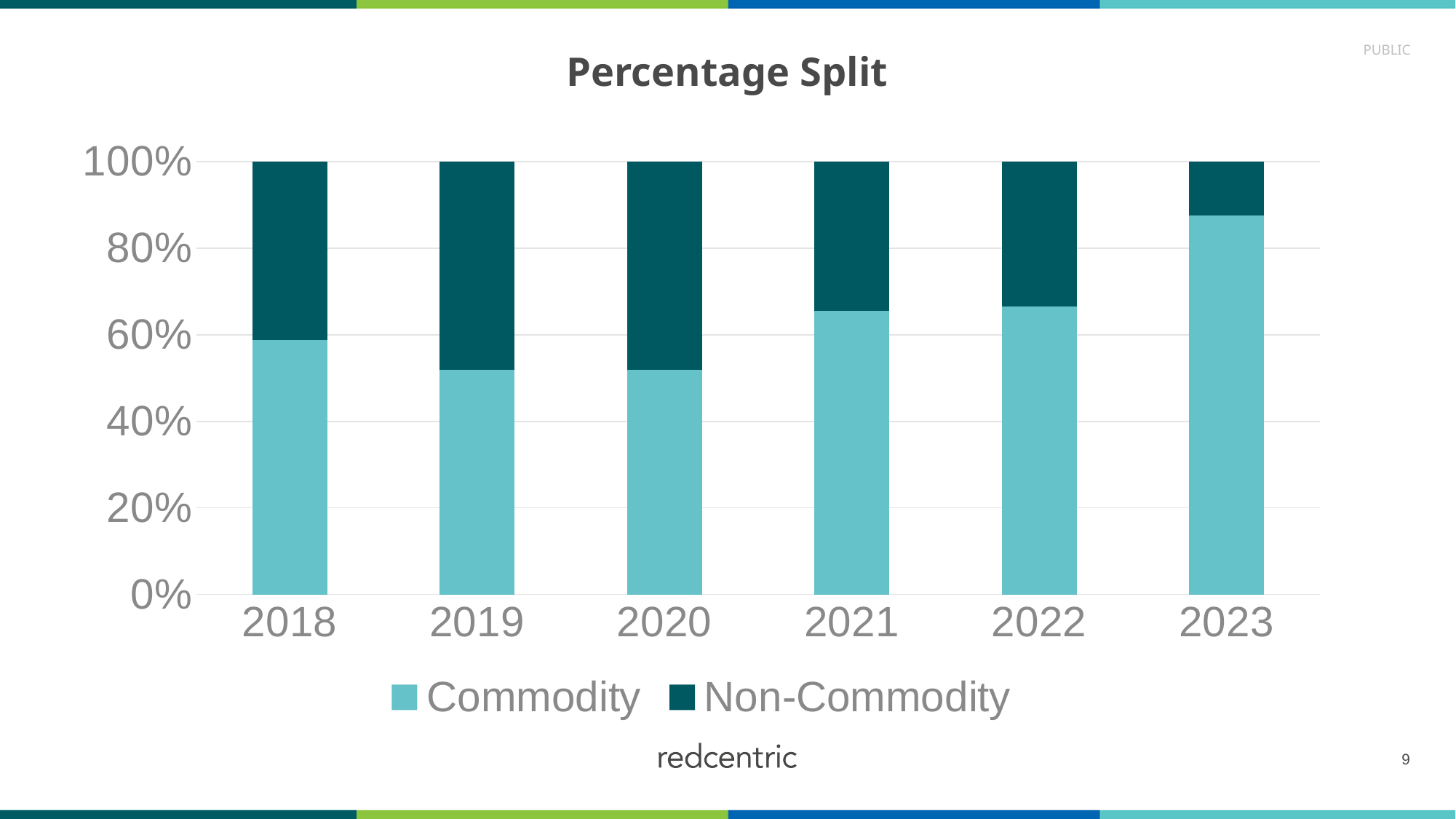
From 2020 to 2023, does the Commodity share rise or fall? Rise Which year has the lowest Non-Commodity share? 2023 What is the title of the chart? Percentage Split What is the total of the stacked bar for 2018? 100% Is the Commodity value for 2023 greater or less than 80%? greater Which year has the larger Commodity share, 2018 or 2023? 2023 Is the Commodity value for 2021 greater or less than 60%? greater How many years are shown on the x axis? 6 How many series does the legend list? 2 Is the Commodity value for 2019 greater or less than 60%? less What kind of chart is shown on the slide? Stacked bar chart Which year has the highest Commodity share? 2023